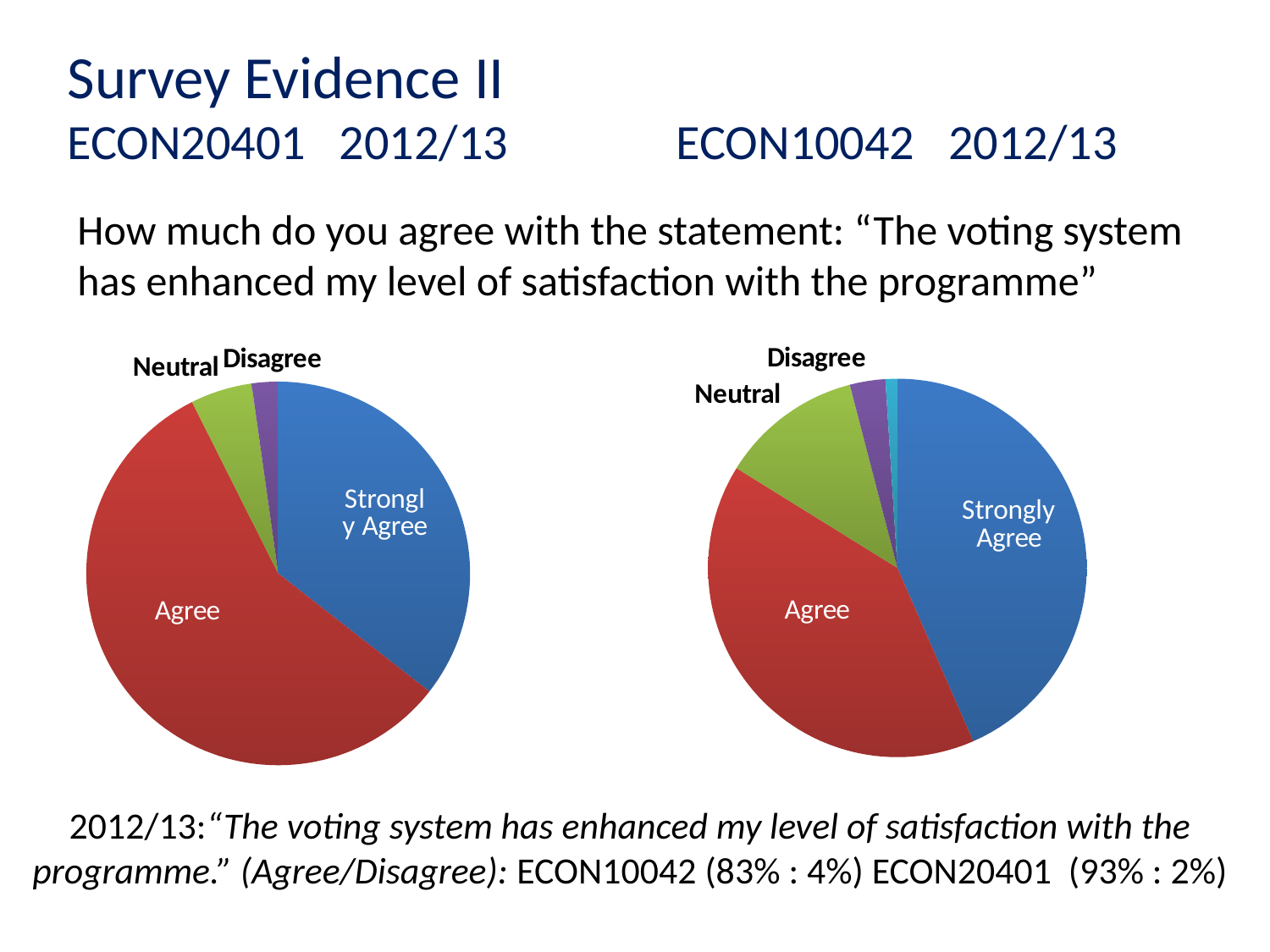
What kind of chart is the ECON10042 2012/13 chart on the right? Pie chart What kind of chart is the ECON20401 2012/13 chart on the left? Pie chart In the ECON10042 2012/13 pie chart on the right, which slice is larger, Strongly Agree or Neutral? Strongly Agree In the ECON20401 2012/13 pie chart on the left, which labelled response has the smallest slice? Disagree In the ECON10042 2012/13 pie chart on the right, which slice is larger, Agree or Disagree? Agree What colour is the Agree slice in the ECON20401 2012/13 pie chart on the left? Red In the ECON20401 2012/13 pie chart on the left, which response has the largest slice? Agree What colour is the Neutral slice in the ECON10042 2012/13 pie chart on the right? Green In the ECON20401 2012/13 pie chart on the left, which slice is larger, Neutral or Disagree? Neutral How many labelled slices does the ECON20401 2012/13 pie chart on the left have? 4